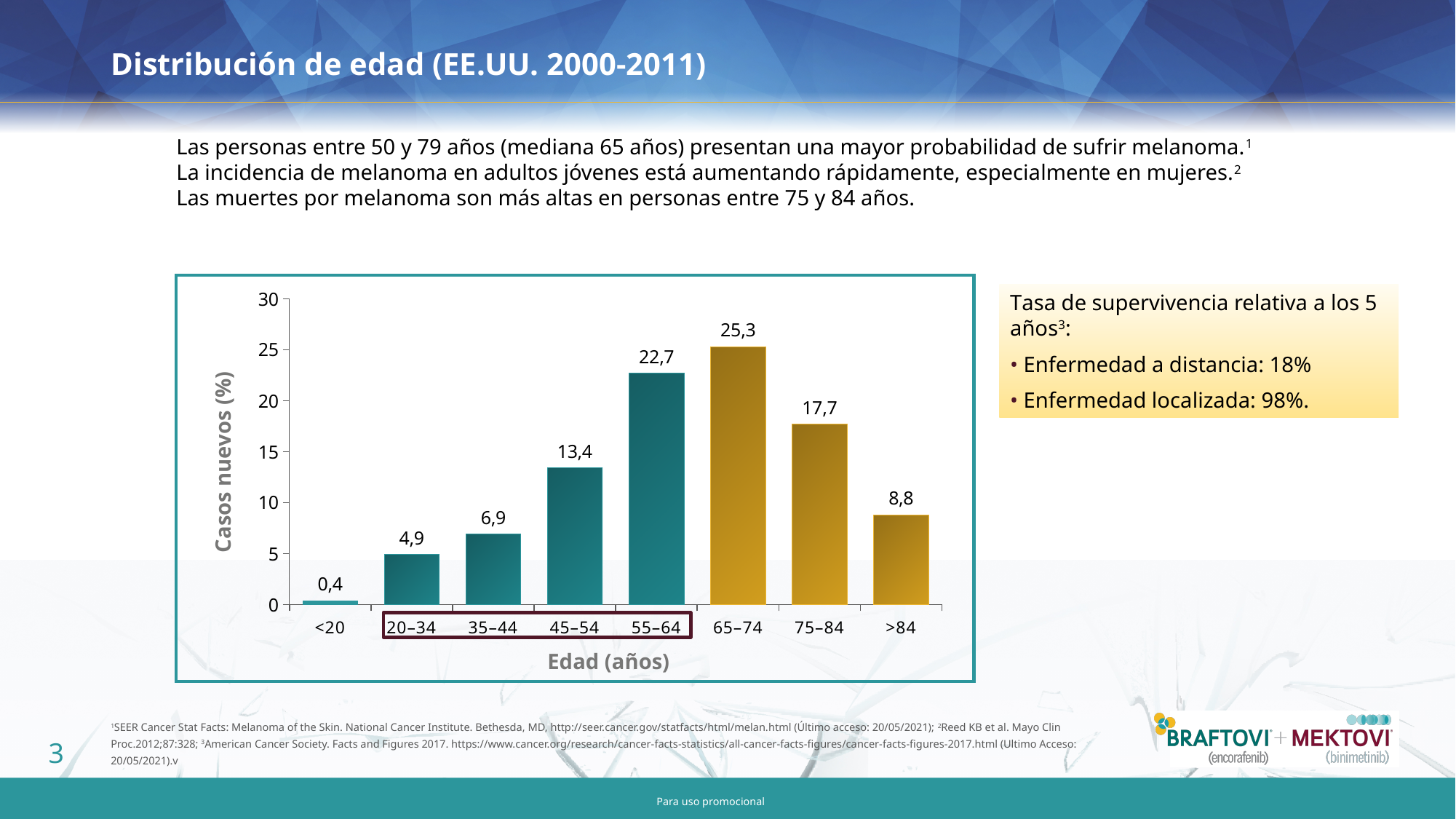
Which age group has the lowest percentage of new cases? <20 What is the value for the 45–54 age group? 13,4 What is the difference between the values for 55–64 and 20–34? 17,8 What is the value for the <20 age group? 0,4 What is the difference between the values for 65–74 and 75–84? 7,6 What kind of chart is shown? bar chart What is the value for the 65–74 age group? 25,3 How many age groups are shown on the x axis? 8 Is the value for 55–64 greater or less than 20? greater Which age group has the highest percentage of new cases? 65–74 What is the label of the y axis? Casos nuevos (%) Which is larger, the value for 35–44 or the value for >84? >84